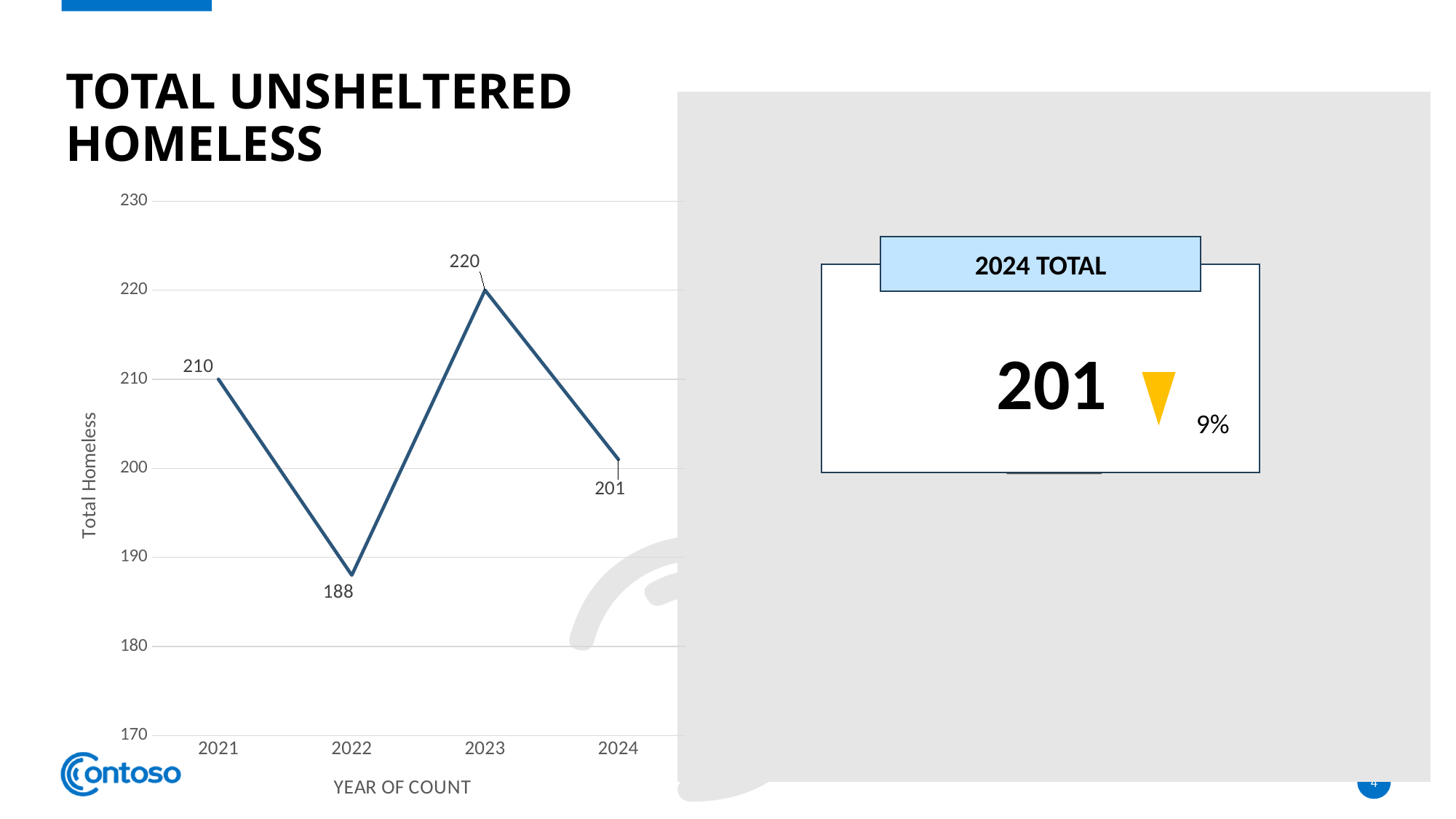
Which is larger, the value for 2021 or the value for 2024? 2021 How many years are plotted on the chart? 4 What kind of chart is shown on the slide? line chart Which year has the lowest value? 2022 What is the value for 2022? 188 Which year has the highest value? 2023 What is the value for 2021? 210 What is the difference between the values for 2023 and 2022? 32 What is the value for 2023? 220 What is the value for 2024? 201 What is the difference between the values for 2021 and 2024? 9 What is the label of the y axis? Total Homeless